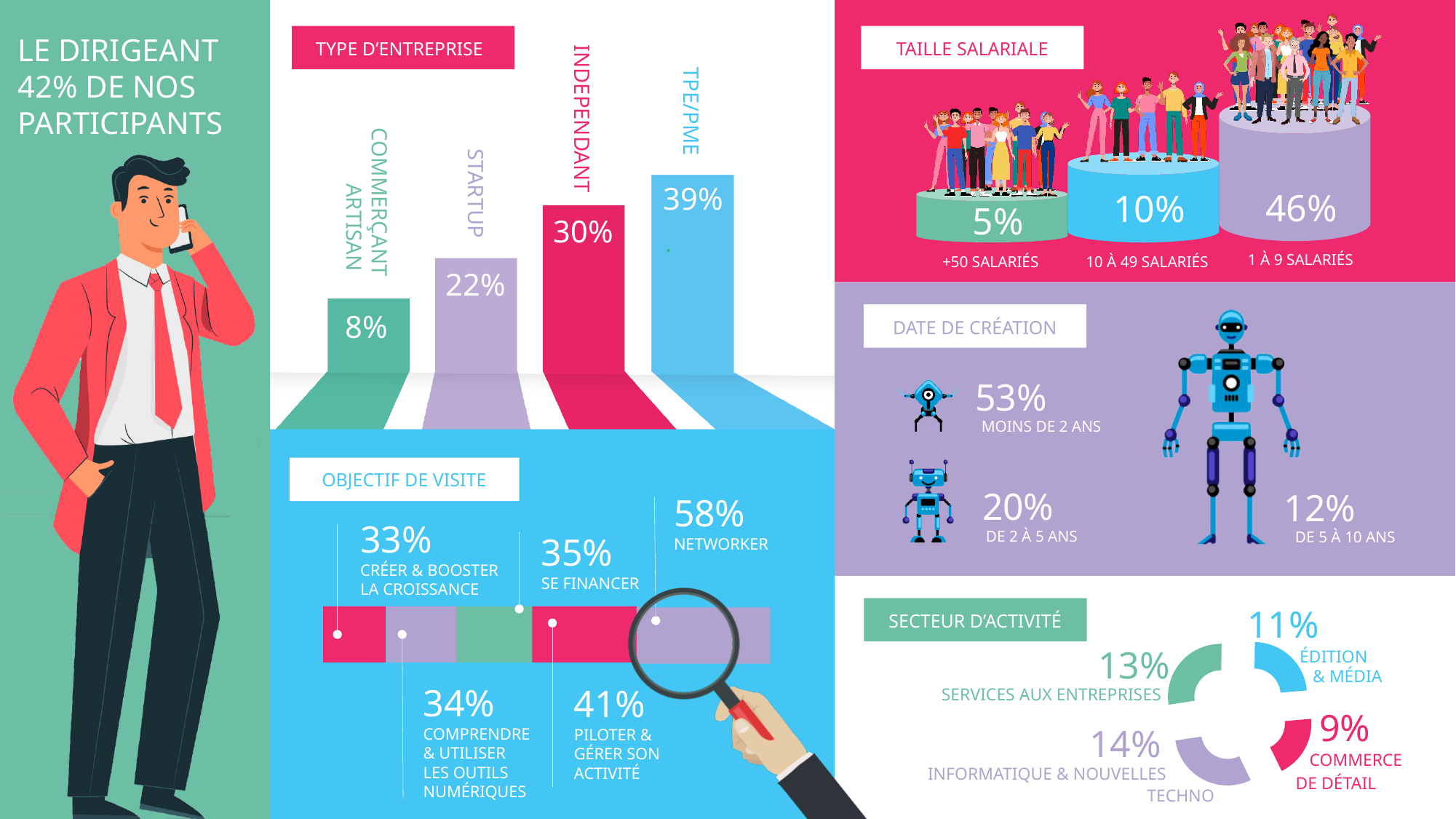
In the TYPE D'ENTREPRISE chart, what is the difference between the values for TPE/PME and INDEPENDANT? 9% In the TYPE D'ENTREPRISE chart, what is the value for STARTUP? 22% What kind of chart is the TYPE D'ENTREPRISE chart? bar chart In the SECTEUR D'ACTIVITÉ chart, what is the value for COMMERCE DE DÉTAIL? 9% In the TAILLE SALARIALE chart, which is larger, +50 SALARIÉS or 10 À 49 SALARIÉS? 10 À 49 SALARIÉS In the OBJECTIF DE VISITE chart, which objective has the highest value? NETWORKER In the DATE DE CRÉATION chart, what is the value for MOINS DE 2 ANS? 53% In the DATE DE CRÉATION chart, what is the difference between DE 2 À 5 ANS and DE 5 À 10 ANS? 8% In the TYPE D'ENTREPRISE chart, which category has the lowest value? COMMERÇANT ARTISAN In the TAILLE SALARIALE chart, what is the value for 1 À 9 SALARIÉS? 46% In the TYPE D'ENTREPRISE chart, which category has the highest value? TPE/PME In the TYPE D'ENTREPRISE chart, how many categories are shown? 4